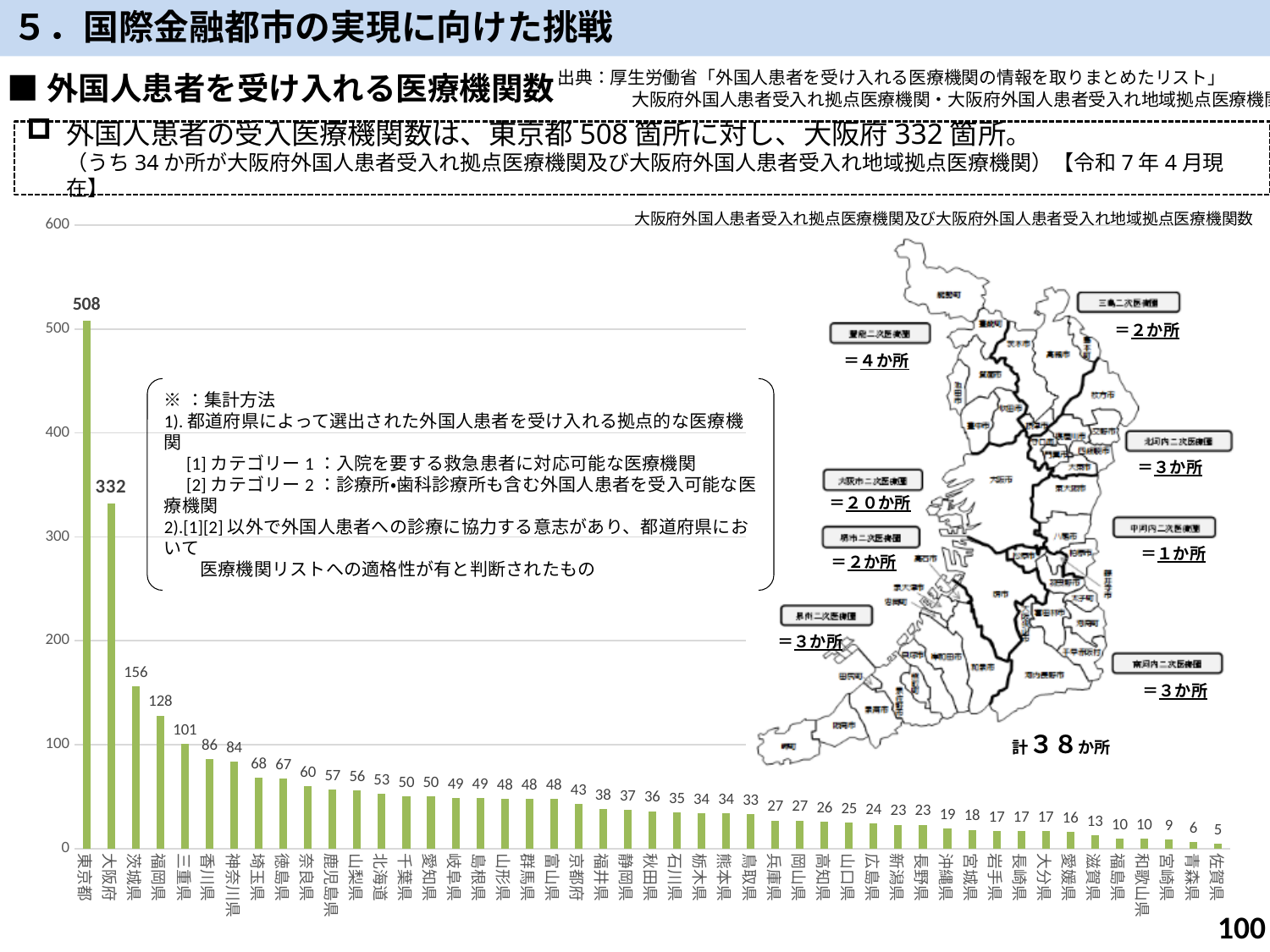
Which prefecture has the lowest value in the bar chart? 佐賀県 What is the value for 大阪府 in the bar chart? 332 Is the value for 神奈川県 greater or less than 100? less Which prefecture has the highest value in the bar chart? 東京都 Which has a larger value, 三重県 or 香川県? 三重県 How many prefectures are shown on the x axis of the bar chart? 47 What kind of chart is used to show the number of medical institutions by prefecture? bar chart What is the value for 茨城県 in the bar chart? 156 What is the difference between the values for 東京都 and 大阪府? 176 What is the value for 福岡県 in the bar chart? 128 Do the values rise or fall from left to right along the x axis? fall What is the value for 東京都 in the bar chart? 508